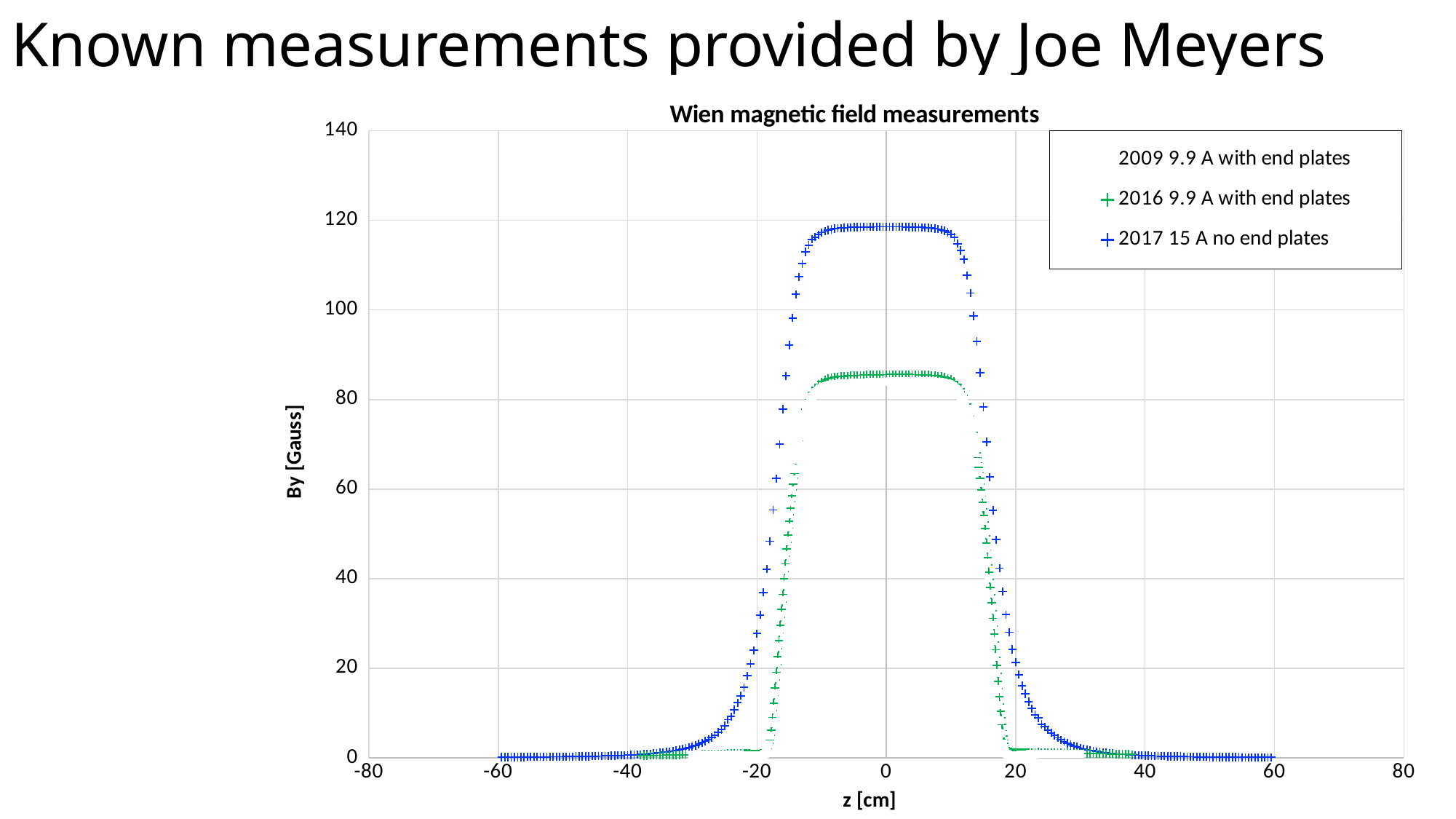
Is the peak value of the 2017 15 A no end plates series greater or less than 100? greater What kind of chart is shown on the slide? scatter chart Is the peak value of the 2016 9.9 A with end plates series greater or less than 80? greater Do the values of the 2017 15 A no end plates series rise or fall as z goes from -60 to 0? rise Do the values of the 2017 15 A no end plates series rise or fall as z goes from 0 to 60? fall Which series has a higher peak, 2016 9.9 A with end plates or 2017 15 A no end plates? 2017 15 A no end plates How many series does the legend list? 3 What is the label of the y axis? By [Gauss] Is the value of the 2017 15 A no end plates series at z = 40 greater or less than 20? less What is the title of the chart? Wien magnetic field measurements Which series reaches the highest peak value? 2017 15 A no end plates